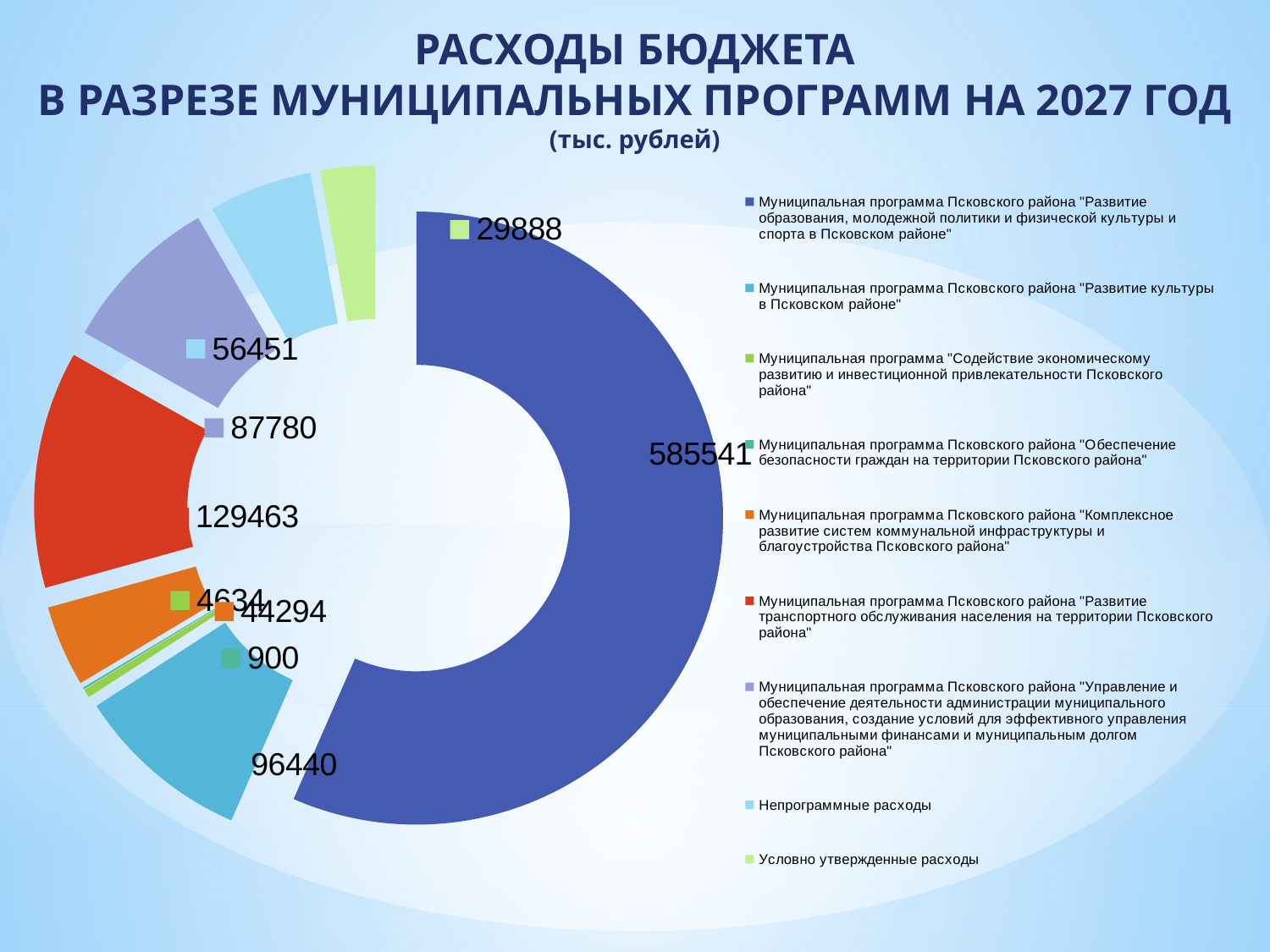
What is the value for the municipal program "Комплексное развитие систем коммунальной инфраструктуры и благоустройства Псковского района"? 44294 What is the value for the municipal program "Развитие культуры в Псковском районе"? 96440 What is the smallest value shown on the chart? 900 Which is larger: the value for the administration management program or the value for "Непрограммные расходы"? The administration management program (87780) What kind of chart is shown on the slide? Doughnut (pie) chart What is the value for "Условно утвержденные расходы"? 29888 Which category has the largest value in the chart? Муниципальная программа Псковского района "Развитие образования, молодежной политики и физической культуры и спорта в Псковском районе" What is the value for the municipal program "Развитие транспортного обслуживания населения на территории Псковского района"? 129463 What is the value for the municipal program "Развитие образования, молодежной политики и физической культуры и спорта в Псковском районе"? 585541 What is the value for "Непрограммные расходы"? 56451 What is the difference between the value for the transport program (129463) and the culture program (96440)? 33023 How many categories does the legend list? 9